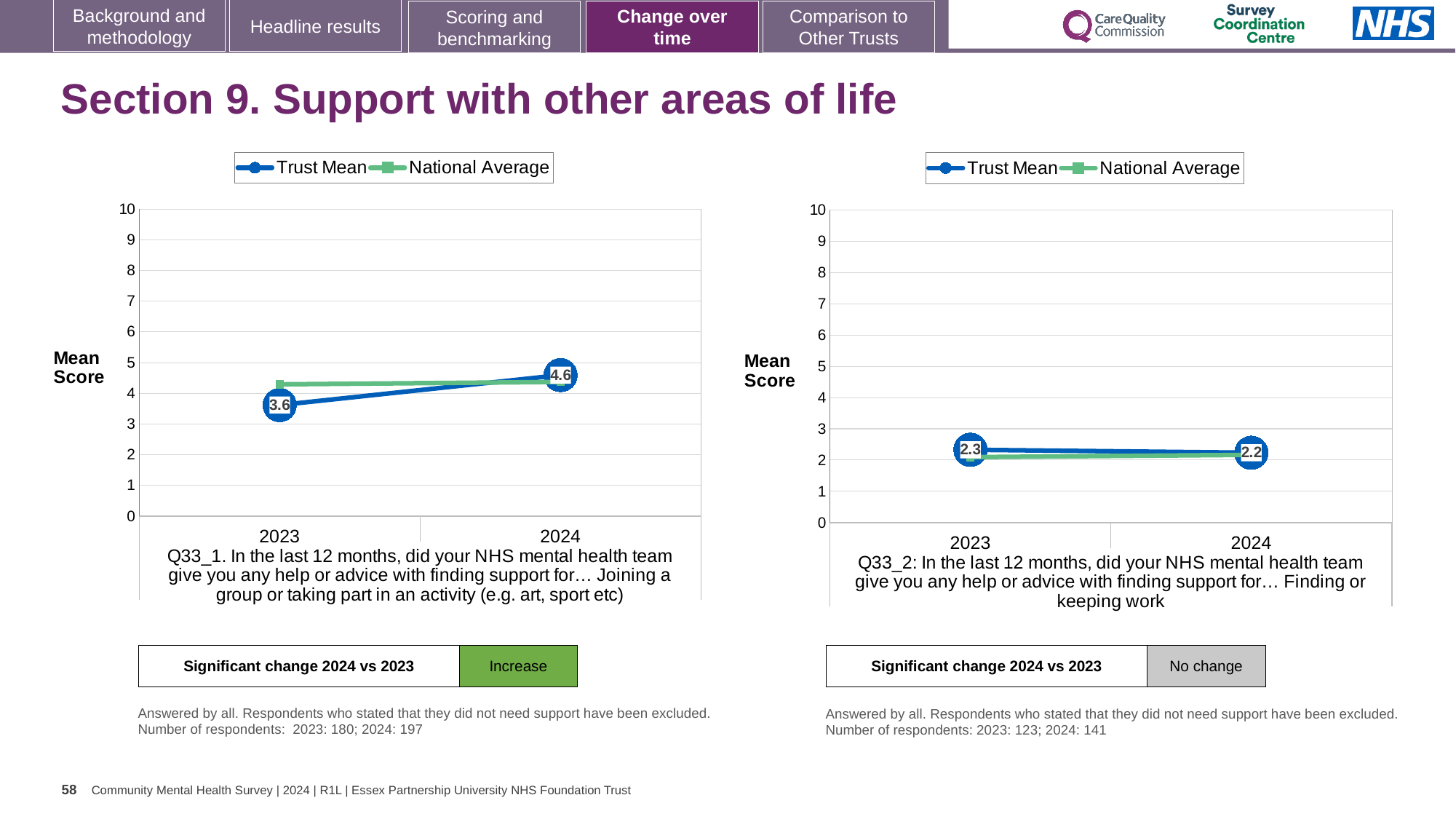
On the left chart (Q33_1), does the Trust Mean rise or fall from 2023 to 2024? rise On the left chart (Q33_1), by how much did the Trust Mean change from 2023 to 2024? 1.0 On the right chart (Q33_2), what is the difference between the Trust Mean for 2023 and 2024? 0.1 On the right chart (Q33_2), does the Trust Mean rise or fall from 2023 to 2024? fall On the right chart (Q33_2), what is the Trust Mean score for 2023? 2.3 On the left chart (Q33_1), is the National Average for 2023 greater or less than 4? greater On the right chart (Q33_2), what is the Trust Mean score for 2024? 2.2 On the left chart (Q33_1), what is the Trust Mean score for 2023? 3.6 How many series does the legend of the left chart (Q33_1) list? 2 What kind of chart is the right chart (Q33_2)? line chart On the left chart (Q33_1), in 2023 which is higher, the Trust Mean or the National Average? National Average On the left chart (Q33_1), what is the Trust Mean score for 2024? 4.6